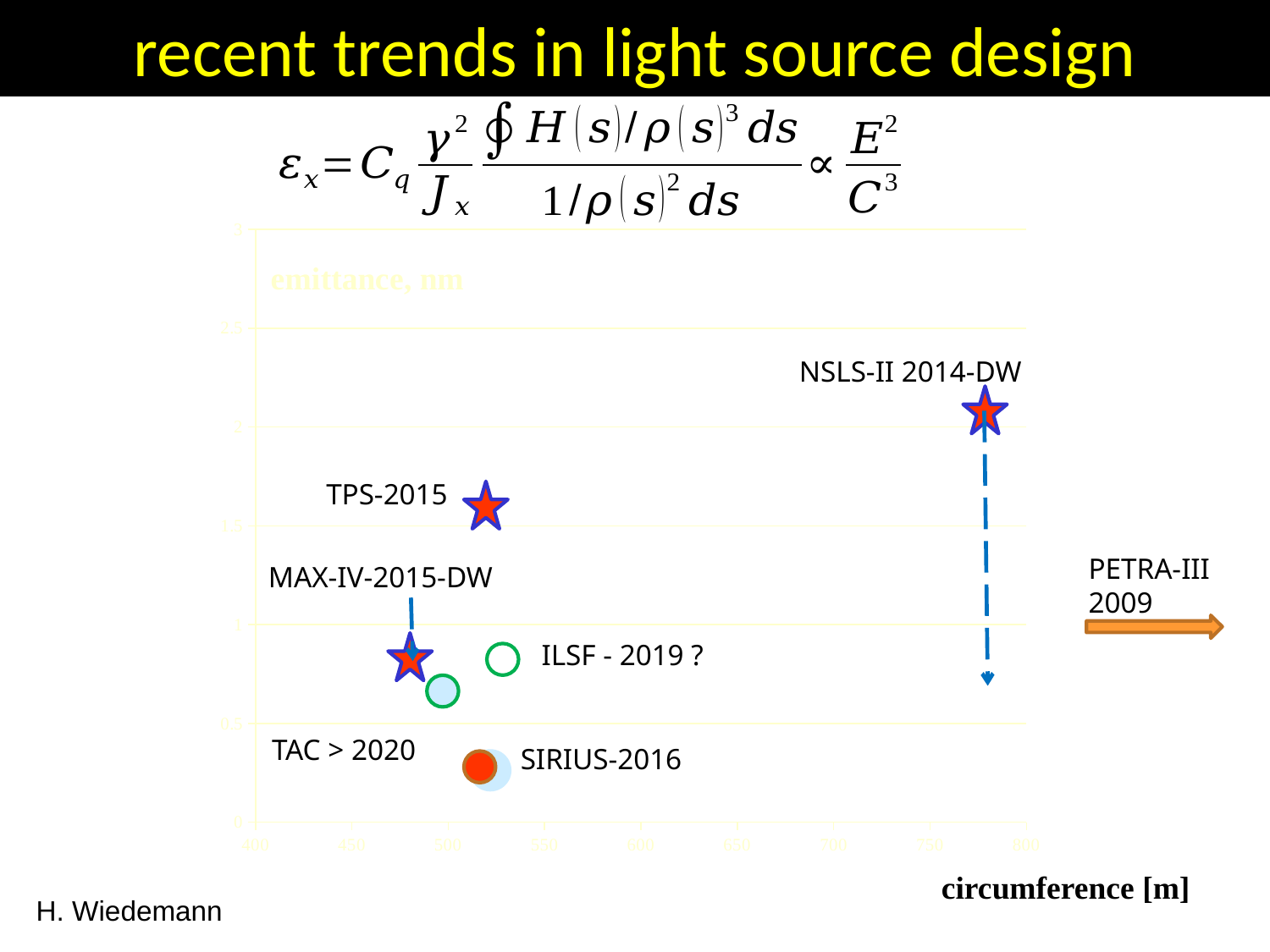
Which labeled light source has the highest emittance on the chart? NSLS-II 2014-DW What quantity is plotted on the vertical axis of the chart? emittance, nm What kind of chart is shown on the slide? scatter chart Is the circumference for MAX-IV-2015-DW greater or less than 500 m? less Is the emittance for MAX-IV-2015-DW greater or less than 1 nm? less Is the emittance for SIRIUS-2016 greater or less than 0.5 nm? less Which has the higher emittance, TPS-2015 or MAX-IV-2015-DW? TPS-2015 What quantity is plotted on the horizontal axis of the chart? circumference [m] Which labeled light source has the lowest emittance on the chart? SIRIUS-2016